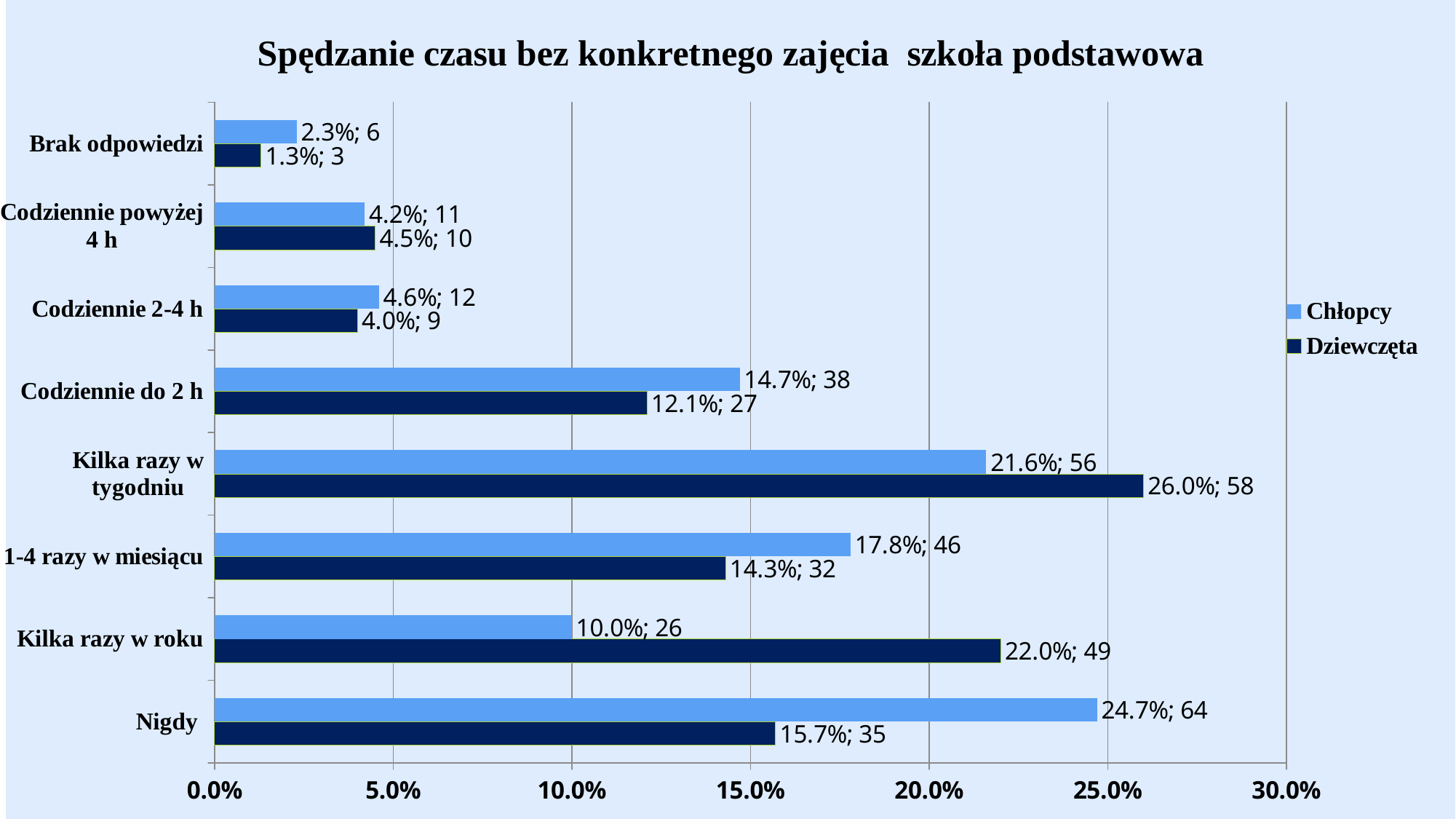
What is the difference in percentage points between Chłopcy and Dziewczęta in the category Nigdy? 9.0% How many series does the legend list? 2 In the category Kilka razy w roku, which series has the larger value, Chłopcy or Dziewczęta? Dziewczęta Which category has the highest percentage for Dziewczęta? Kilka razy w tygodniu How many categories are shown on the chart? 8 What is the title of the chart? Spędzanie czasu bez konkretnego zajęcia szkoła podstawowa Which category has the lowest percentage for Chłopcy? Brak odpowiedzi What percentage is shown for Dziewczęta in the category Kilka razy w roku? 22.0% What is the data label for Dziewczęta in the category Codziennie do 2 h? 12.1%; 27 What is the data label for Chłopcy in the category Nigdy? 24.7%; 64 What type of chart is shown on the slide? bar chart Is the value for Chłopcy in the category 1-4 razy w miesiącu greater or less than 15.0%? greater